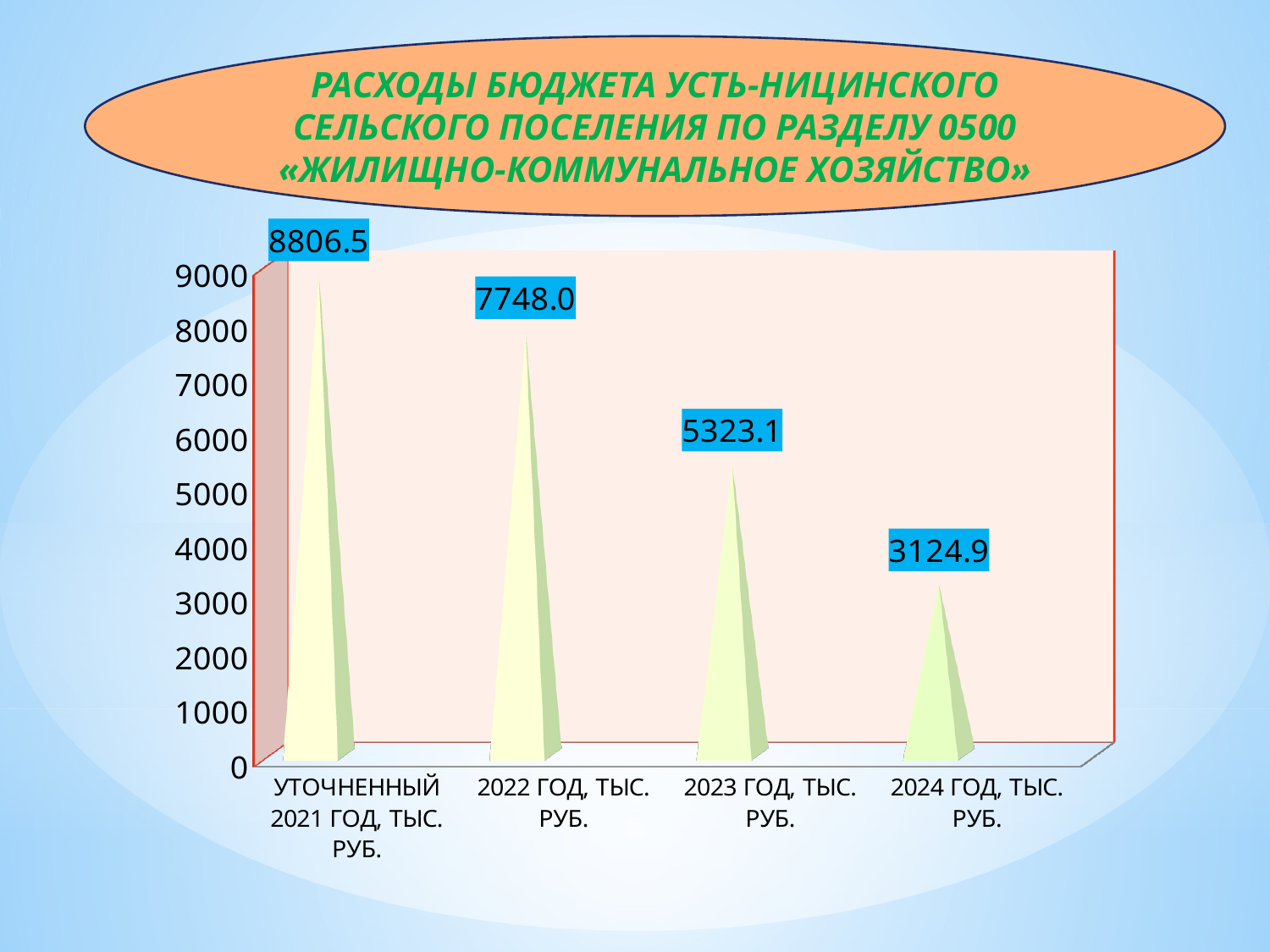
What is the value for 2022 год, тыс. руб.? 7748.0 Is the value for 2023 год, тыс. руб. greater or less than 5000? greater What is the value for 2024 год, тыс. руб.? 3124.9 Which category has the highest value? Уточненный 2021 год, тыс. руб. Which category has the lowest value? 2024 год, тыс. руб. What is the difference between the values for 2023 год and 2024 год? 2198.2 Do the values rise or fall from left to right along the x axis? fall What kind of chart is shown on the slide? bar chart What is the difference between the values for Уточненный 2021 год and 2022 год? 1058.5 What is the value for Уточненный 2021 год, тыс. руб.? 8806.5 How many categories are shown on the x axis? 4 Which is larger, the value for 2022 год or the value for 2023 год? 2022 год, тыс. руб.